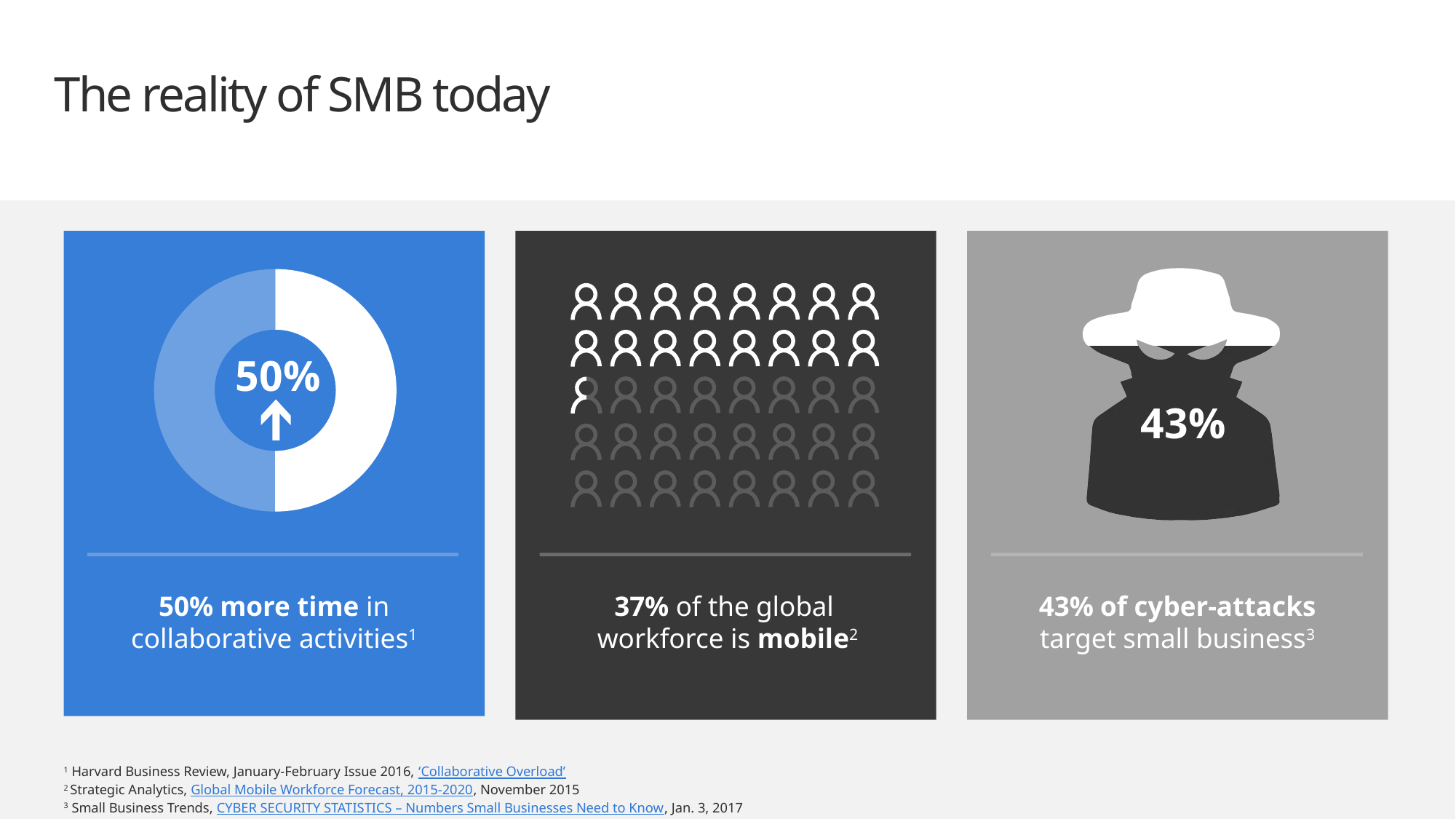
According to the right panel, what percentage of cyber-attacks target small business? 43% What is the title of the slide? The reality of SMB today What background colour does the panel containing the donut chart have? Blue According to the middle panel, what percentage of the global workforce is mobile? 37% Which of the three statistics on the slide has the lowest percentage? 37% of the global workforce is mobile What kind of chart is shown in the left (blue) panel? Donut (pie) chart How many statistic panels are shown on the slide? 3 What is the difference in percentage points between the collaborative activities figure (50%) and the mobile workforce figure (37%)? 13 percentage points Which of the three statistics on the slide has the highest percentage? 50% more time in collaborative activities What is the difference in percentage points between the cyber-attacks figure (43%) and the mobile workforce figure (37%)? 6 percentage points What value is printed in the centre of the donut chart in the left panel? 50% Which is larger: the share of cyber-attacks targeting small business or the share of the global workforce that is mobile? Cyber-attacks targeting small business (43%)